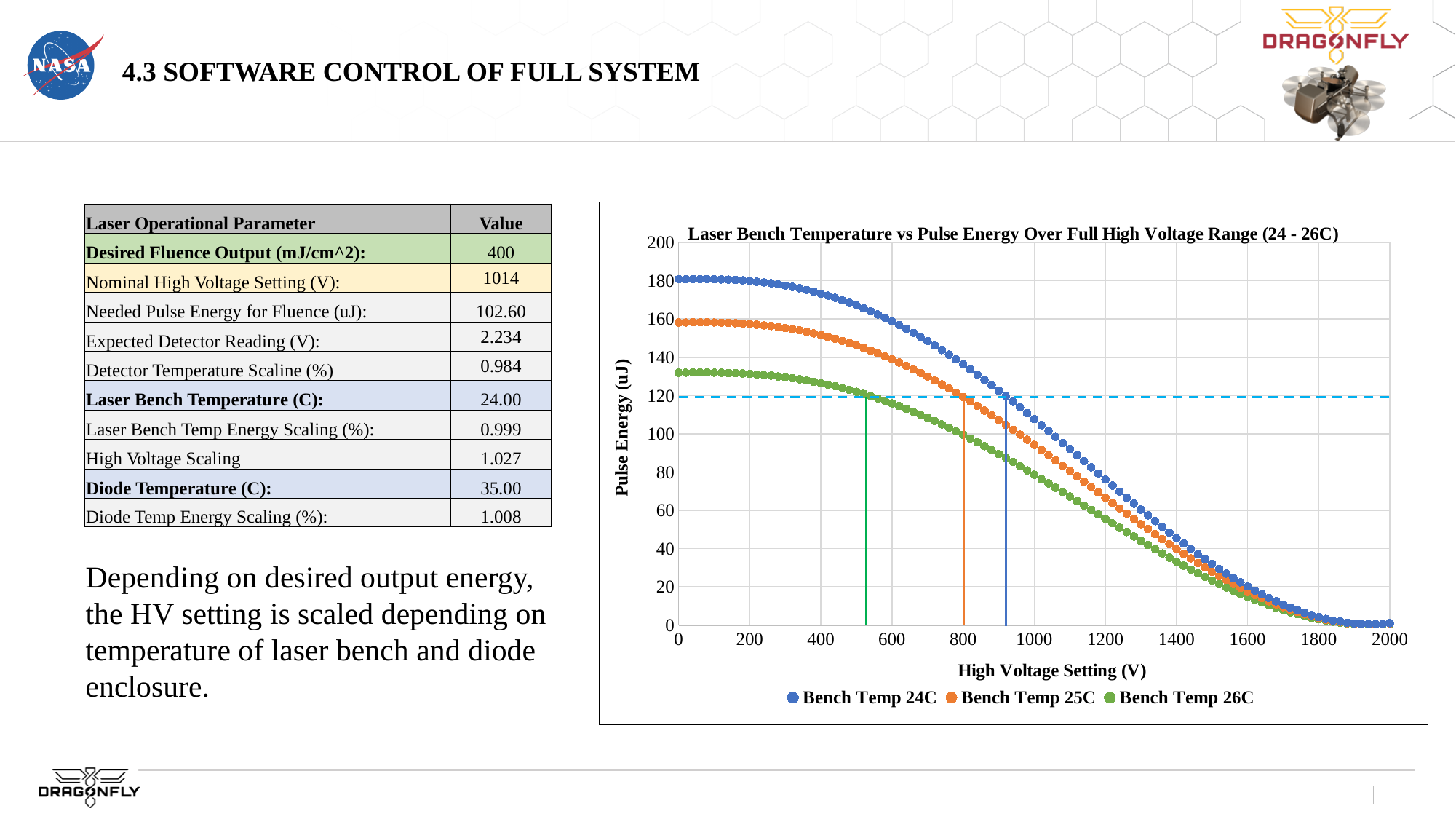
What is the title of the chart? Laser Bench Temperature vs Pulse Energy Over Full High Voltage Range (24 - 26C) Is the pulse energy for Bench Temp 25C at 0 V greater or less than 140? greater Do the pulse energy values for Bench Temp 24C rise or fall as the high voltage setting increases? fall Is the pulse energy for Bench Temp 24C at 1600 V greater or less than 40? less Is the pulse energy for Bench Temp 24C at 0 V greater or less than 160? greater What value on the Pulse Energy axis does the horizontal dashed line in the chart mark? 120 Which series has the lowest pulse energy at a high voltage setting of 0 V? Bench Temp 26C How many series does the legend of the chart list? 3 At a high voltage setting of 1000 V, which series has the higher pulse energy, Bench Temp 24C or Bench Temp 26C? Bench Temp 24C What kind of chart is shown on the slide? scatter chart Which series has the highest pulse energy at a high voltage setting of 0 V? Bench Temp 24C